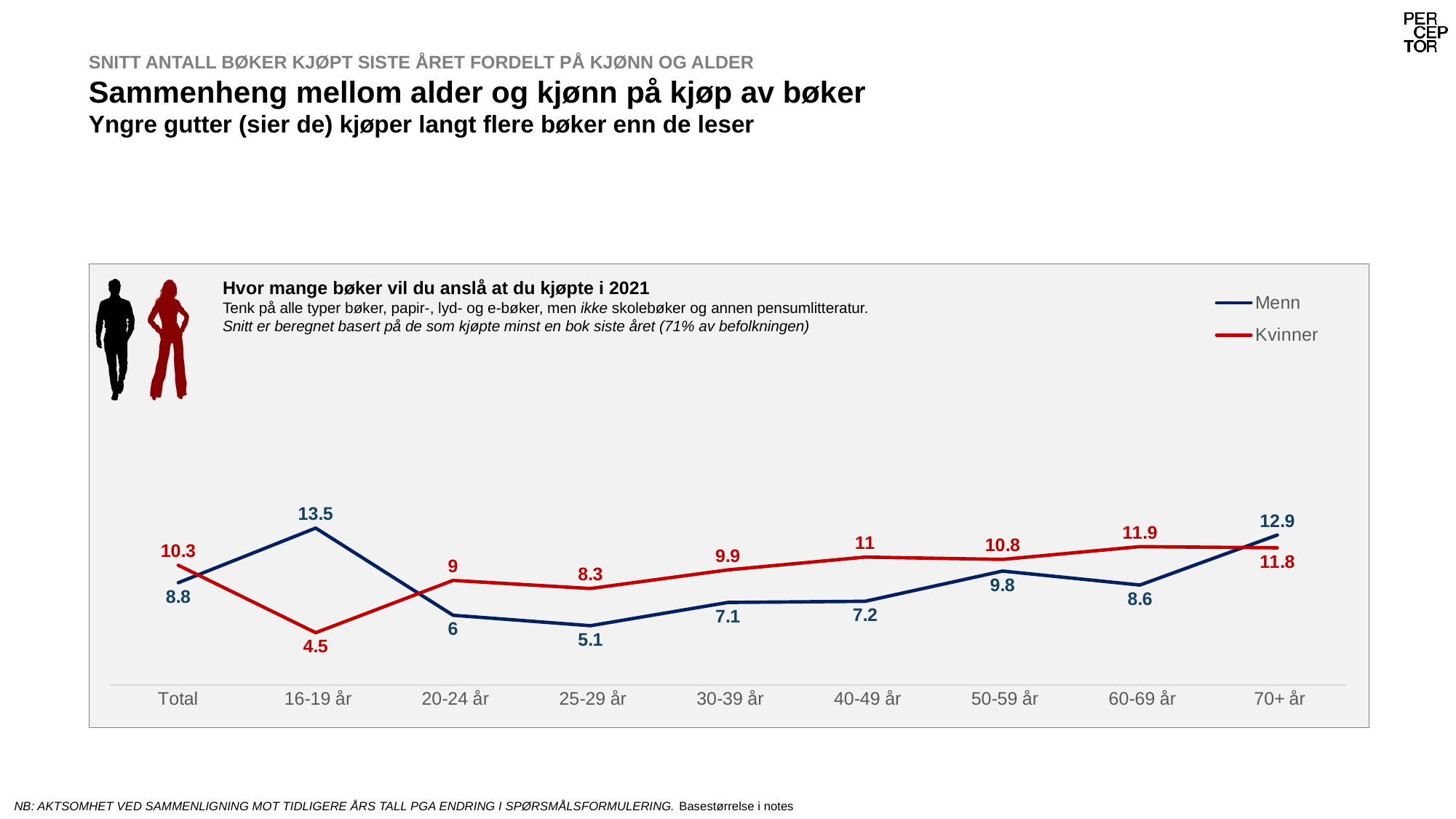
What is the difference between Menn and Kvinner in the 16-19 år category? 9 Which age category has the lowest value for Kvinner? 16-19 år What is the value for Kvinner in the 40-49 år category? 11 What is the value for Menn in the Total category? 8.8 How many series does the legend list? 2 Which category has the lowest value for Menn? 25-29 år What is the value for Menn in the 16-19 år category? 13.5 Which age category has the highest value for Menn? 16-19 år How many categories are shown on the x axis? 9 What kind of chart is shown on the slide? Line chart Which is larger in the 70+ år category, Menn or Kvinner? Menn Which colour is used for the Kvinner series? Red